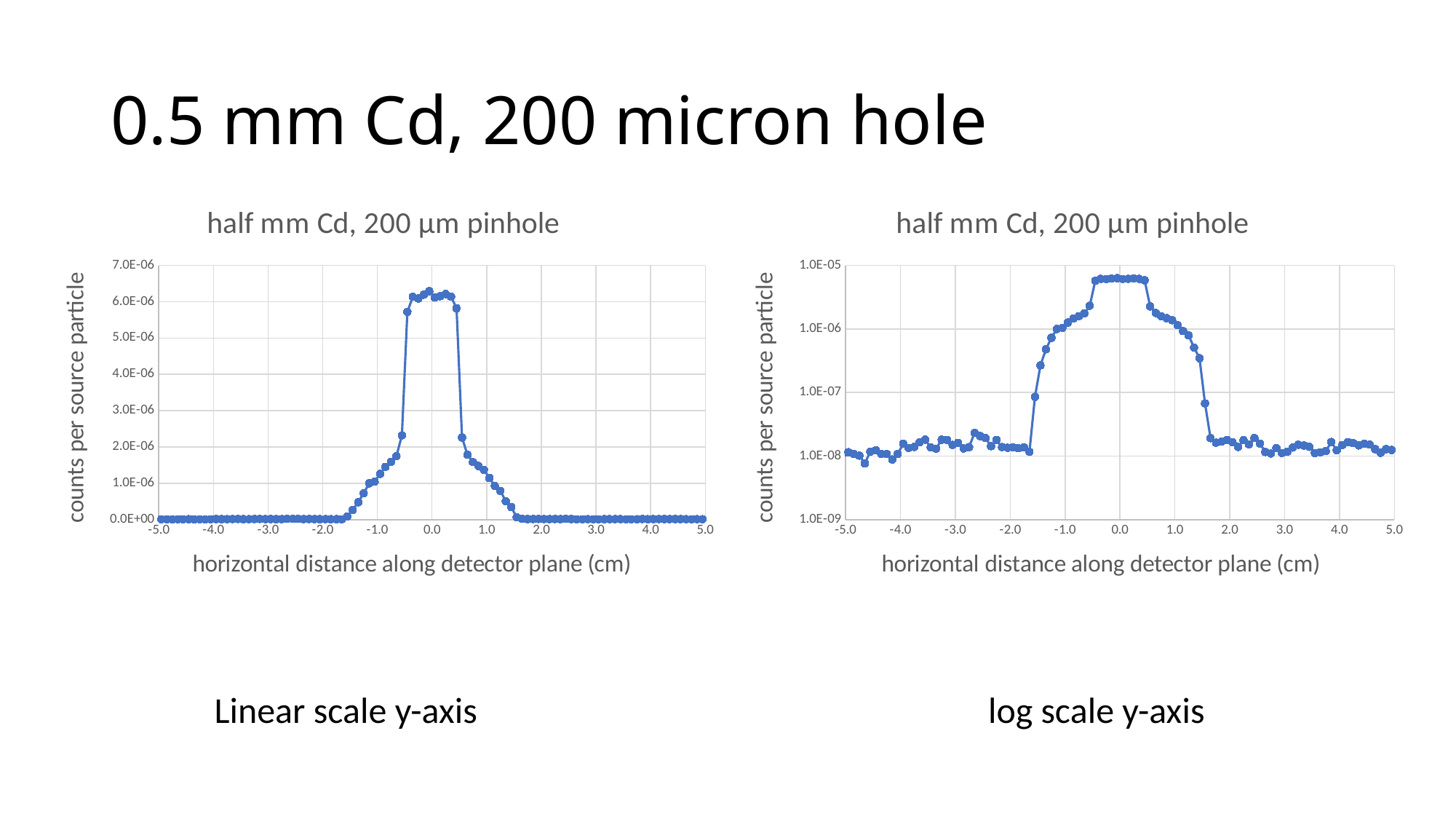
On the left chart (linear scale y-axis), is the value at a horizontal distance of 0.0 cm greater or less than 5.0E-06? greater On the left chart (linear scale y-axis), which is larger: the value at 0.0 cm or the value at 2.0 cm? 0.0 cm On the right chart (log scale y-axis), is the value at a horizontal distance of 3.0 cm greater or less than 1.0E-07? less What is the y-axis label on the left chart? counts per source particle On the right chart (log scale y-axis), is the value at a horizontal distance of 0.0 cm greater or less than 1.0E-06? greater What is the x-axis label on the right chart? horizontal distance along detector plane (cm) What kind of chart is the left chart titled 'half mm Cd, 200 µm pinhole'? line chart On the left chart (linear scale y-axis), do the values rise or fall as the horizontal distance goes from 0.5 cm to 2.0 cm? fall On the right chart (log scale y-axis), do the values rise or fall as the horizontal distance goes from -2.0 cm to 0.0 cm? rise